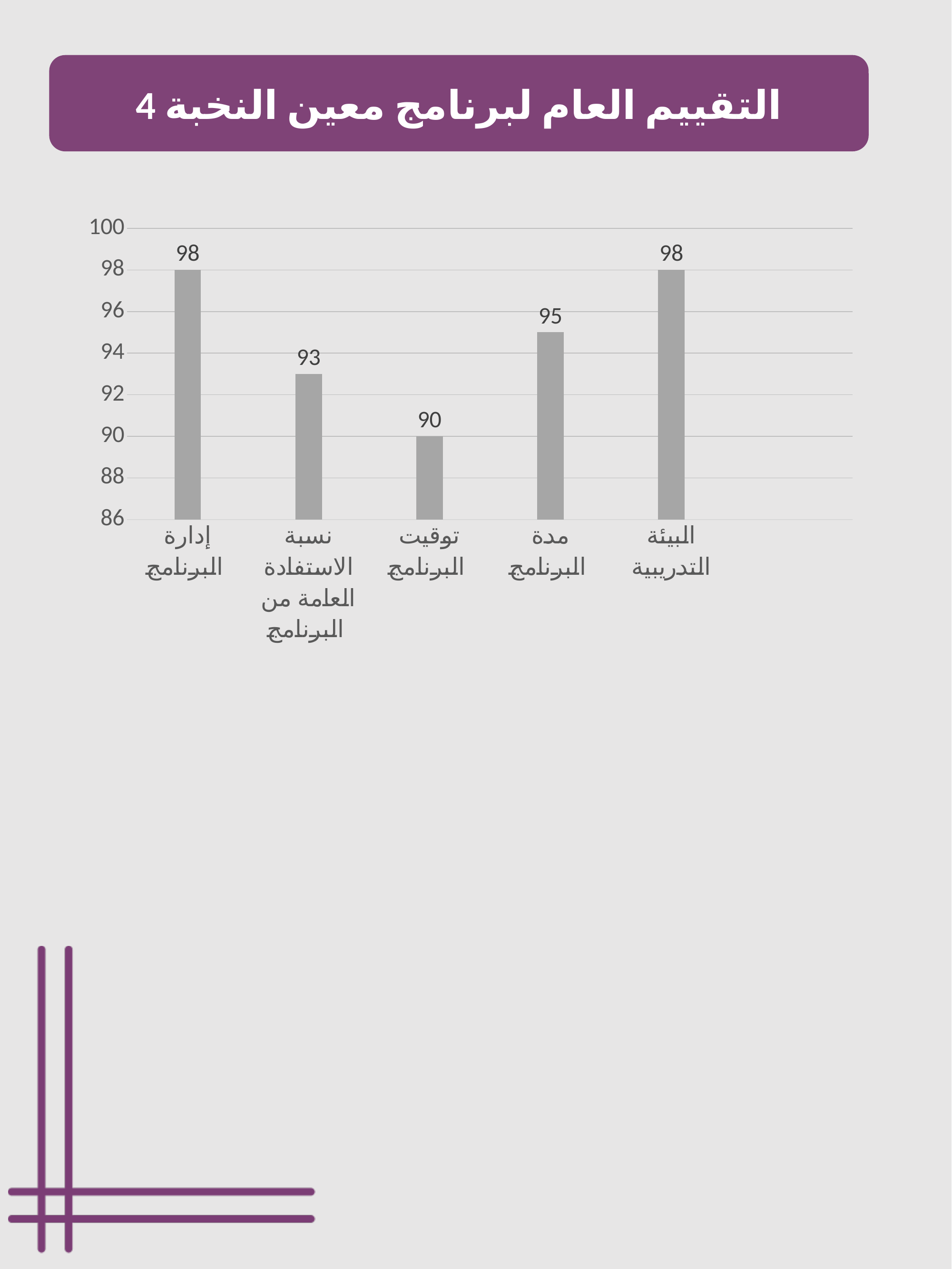
What is the value for نسبة الاستفادة العامة من البرنامج? 93 What is the value for البيئة التدريبية? 98 What kind of chart is shown on the slide? bar chart How many categories are shown in the chart? 5 What is the difference between the values for إدارة البرنامج and توقيت البرنامج? 8 What is the difference between the values for مدة البرنامج and نسبة الاستفادة العامة من البرنامج? 2 What is the value for مدة البرنامج? 95 What is the title of the slide? التقييم العام لبرنامج معين النخبة 4 Which category has the lowest value? توقيت البرنامج Which is larger, the value for مدة البرنامج or the value for نسبة الاستفادة العامة من البرنامج? مدة البرنامج What is the value for إدارة البرنامج? 98 What is the value for توقيت البرنامج? 90